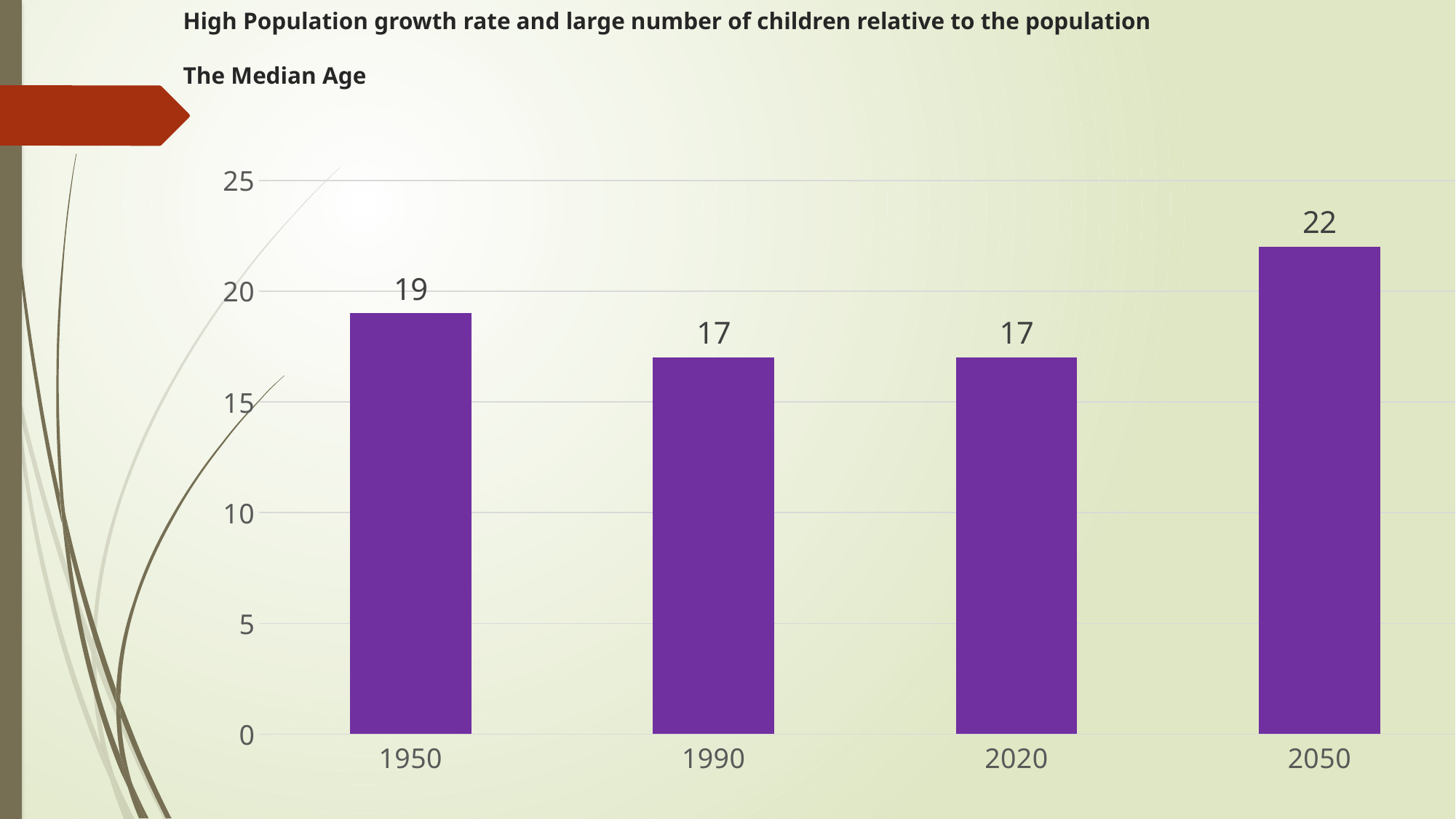
What kind of chart is shown on the slide? bar chart What is the title of the chart? The Median Age What is the difference between the median age in 1950 and in 2020? 2 Which is larger, the median age for 1950 or for 1990? 1950 Which year has the highest median age? 2050 What is the median age shown for 2050? 22 What is the median age shown for 1990? 17 How many years are shown on the x axis? 4 What is the difference between the median age in 2050 and in 1950? 3 What is the median age shown for 1950? 19 Is the median age for 2050 greater or less than 20? greater Is the median age for 2020 greater or less than 20? less